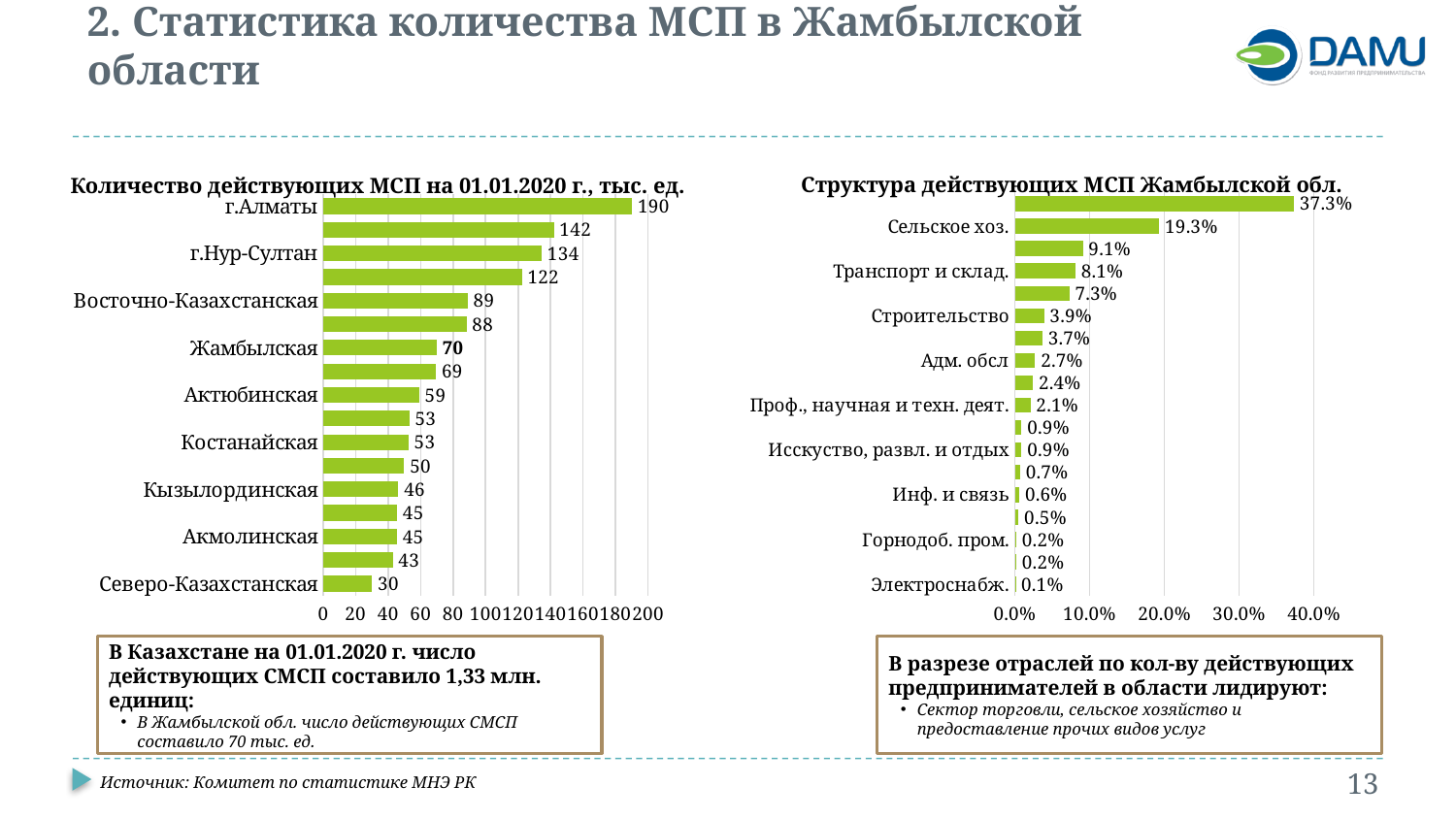
In the chart 'Количество действующих МСП на 01.01.2020 г., тыс. ед.', what is the difference between г.Алматы and г.Нур-Султан? 56 In the chart 'Структура действующих МСП Жамбылской обл.', what is the difference between Строительство and Адм. обсл? 1.2% In the chart 'Структура действующих МСП Жамбылской обл.', what is the value for Сельское хоз.? 19.3% In the chart 'Количество действующих МСП на 01.01.2020 г., тыс. ед.', which labeled region has the highest value? г.Алматы In the chart 'Количество действующих МСП на 01.01.2020 г., тыс. ед.', which labeled region has the lowest value? Северо-Казахстанская In the chart 'Структура действующих МСП Жамбылской обл.', what is the value for Электроснабж.? 0.1% What type of chart is 'Структура действующих МСП Жамбылской обл.'? Bar chart In the chart 'Количество действующих МСП на 01.01.2020 г., тыс. ед.', how many bars are plotted? 17 In the chart 'Структура действующих МСП Жамбылской обл.', what is the value for Транспорт и склад.? 8.1% In the chart 'Количество действующих МСП на 01.01.2020 г., тыс. ед.', what is the value for Жамбылская? 70 In the chart 'Количество действующих МСП на 01.01.2020 г., тыс. ед.', what is the value for г.Алматы? 190 In the chart 'Количество действующих МСП на 01.01.2020 г., тыс. ед.', which is larger: Актюбинская or Костанайская? Актюбинская